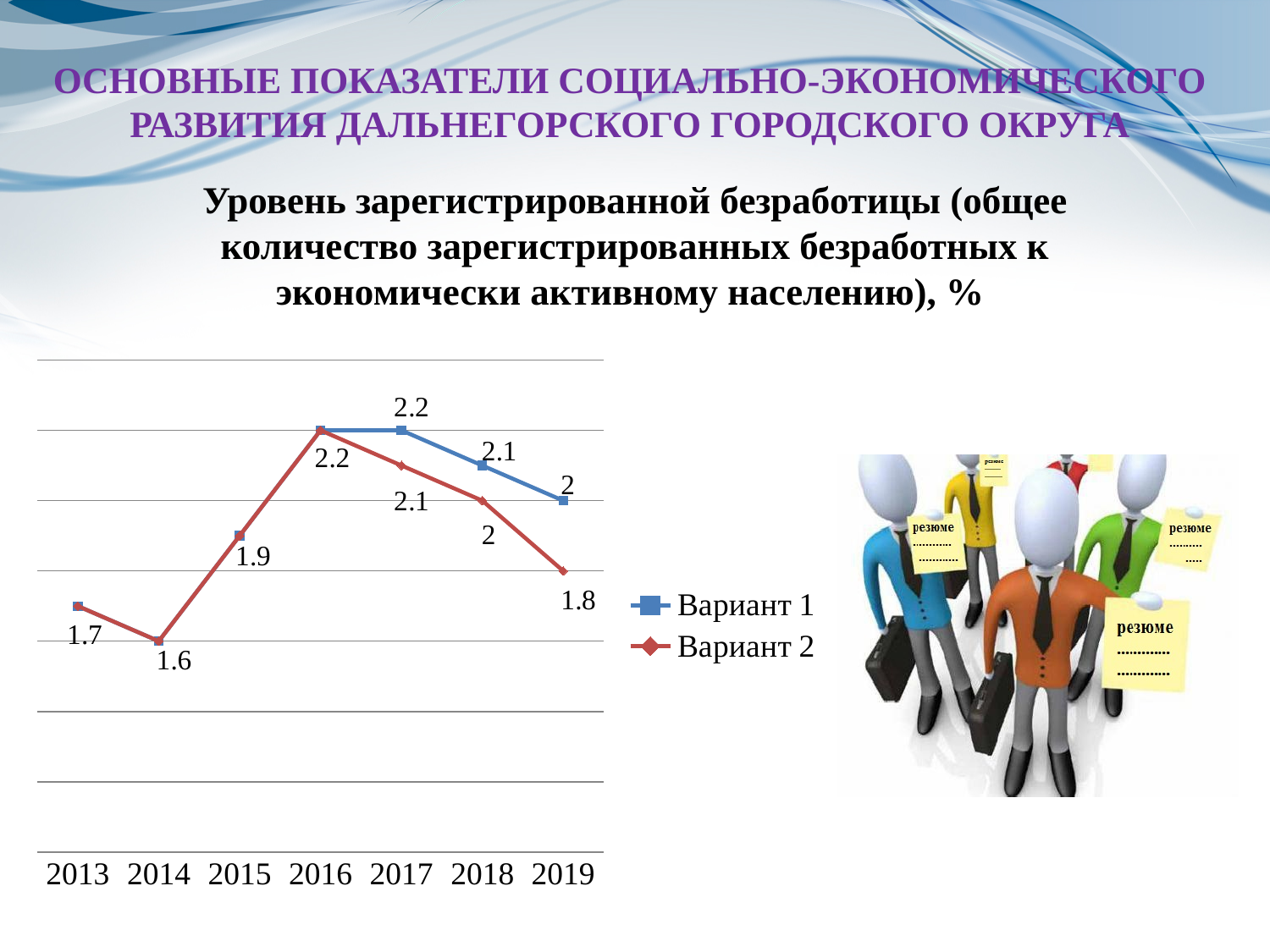
Which year has the lowest value? 2014 What is the value for Вариант 2 in 2017? 2.1 Do the values for Вариант 2 rise or fall from 2016 to 2019? fall What is the value for Вариант 2 in 2019? 1.8 Which is larger in 2018, Вариант 1 or Вариант 2? Вариант 1 Which year has the highest value for Вариант 2? 2016 How many years are shown on the x axis? 7 What is the difference between Вариант 1 and Вариант 2 in 2019? 0.2 What type of chart is shown on the slide? line chart How many series does the legend list? 2 What is the value for Вариант 1 in 2019? 2 What is the value in 2014? 1.6